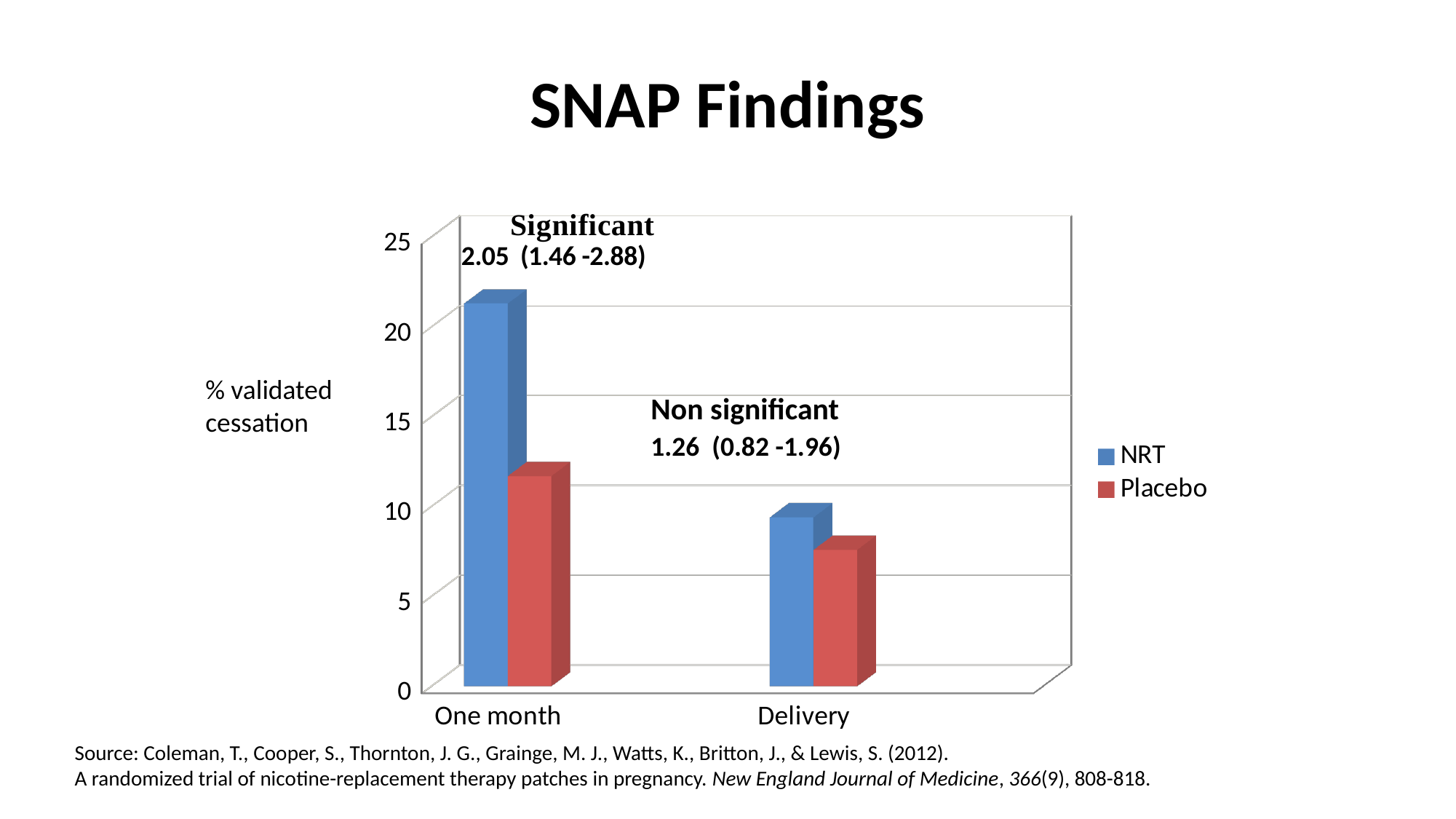
How many categories are shown on the x axis? 2 Which series and category has the tallest bar? NRT at One month Does the NRT value rise or fall from One month to Delivery? Fall At One month, which is larger, NRT or Placebo? NRT What type of chart is shown on the slide? Bar chart At Delivery, which is larger, NRT or Placebo? NRT What is the title of the chart? SNAP Findings Is the value for NRT at One month greater or less than 15? greater Which series and category has the shortest bar? Placebo at Delivery What is the label on the y axis? % validated cessation Is the value for Placebo at Delivery greater or less than 10? less How many series does the legend list? 2